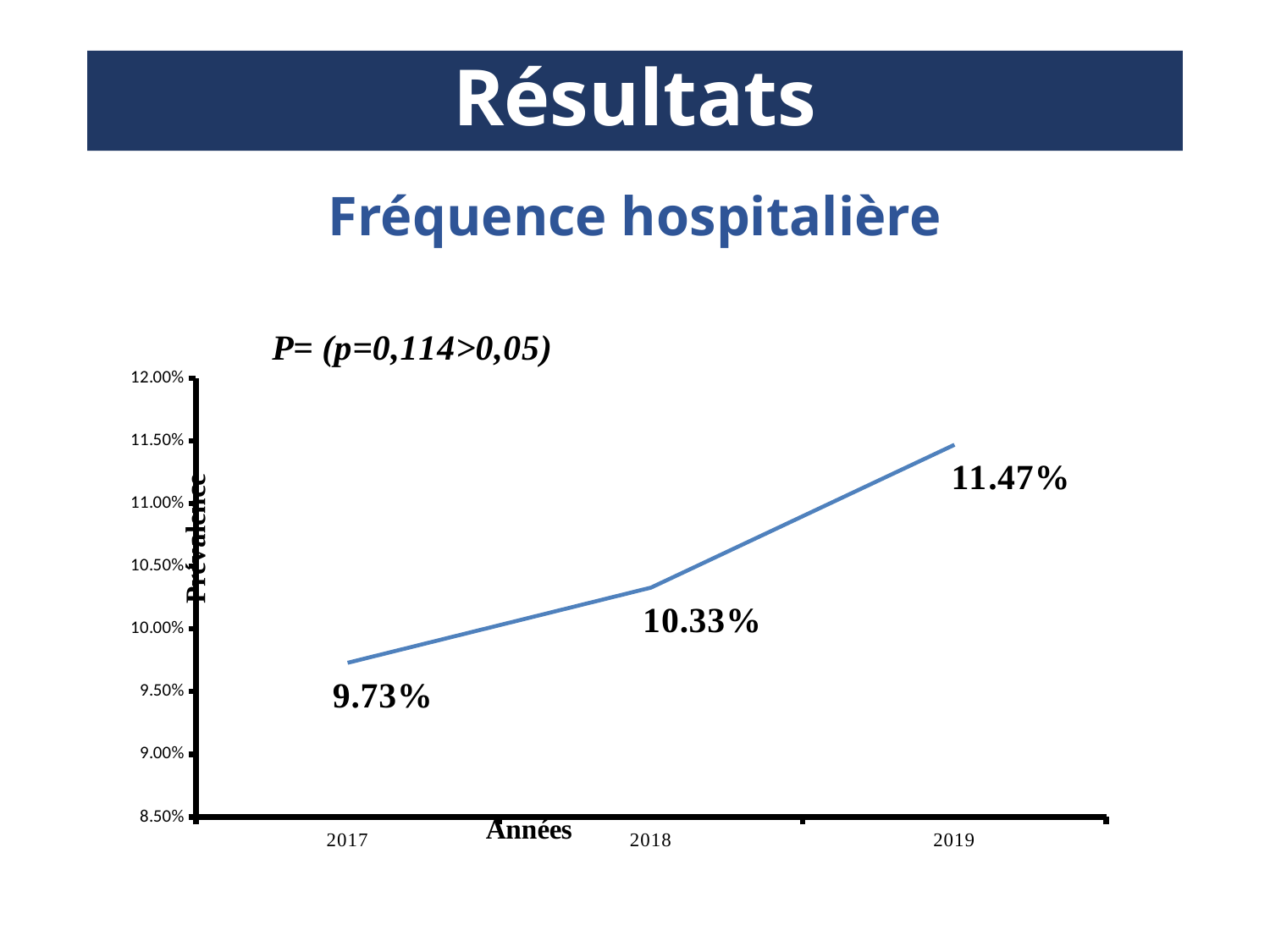
What is the value for 2017? 9.73% What is the difference between the values for 2018 and 2017? 0.60% How many years are plotted on the chart? 3 Which year has the lowest value? 2017 What kind of chart is shown? line chart What is the value for 2019? 11.47% Do the values rise or fall from 2017 to 2019? rise Which year has the highest value? 2019 What is the value for 2018? 10.33% Which is larger, the value for 2018 or the value for 2019? 2019 What is the difference between the values for 2019 and 2017? 1.74% Is the value for 2019 greater or less than 11.00%? greater